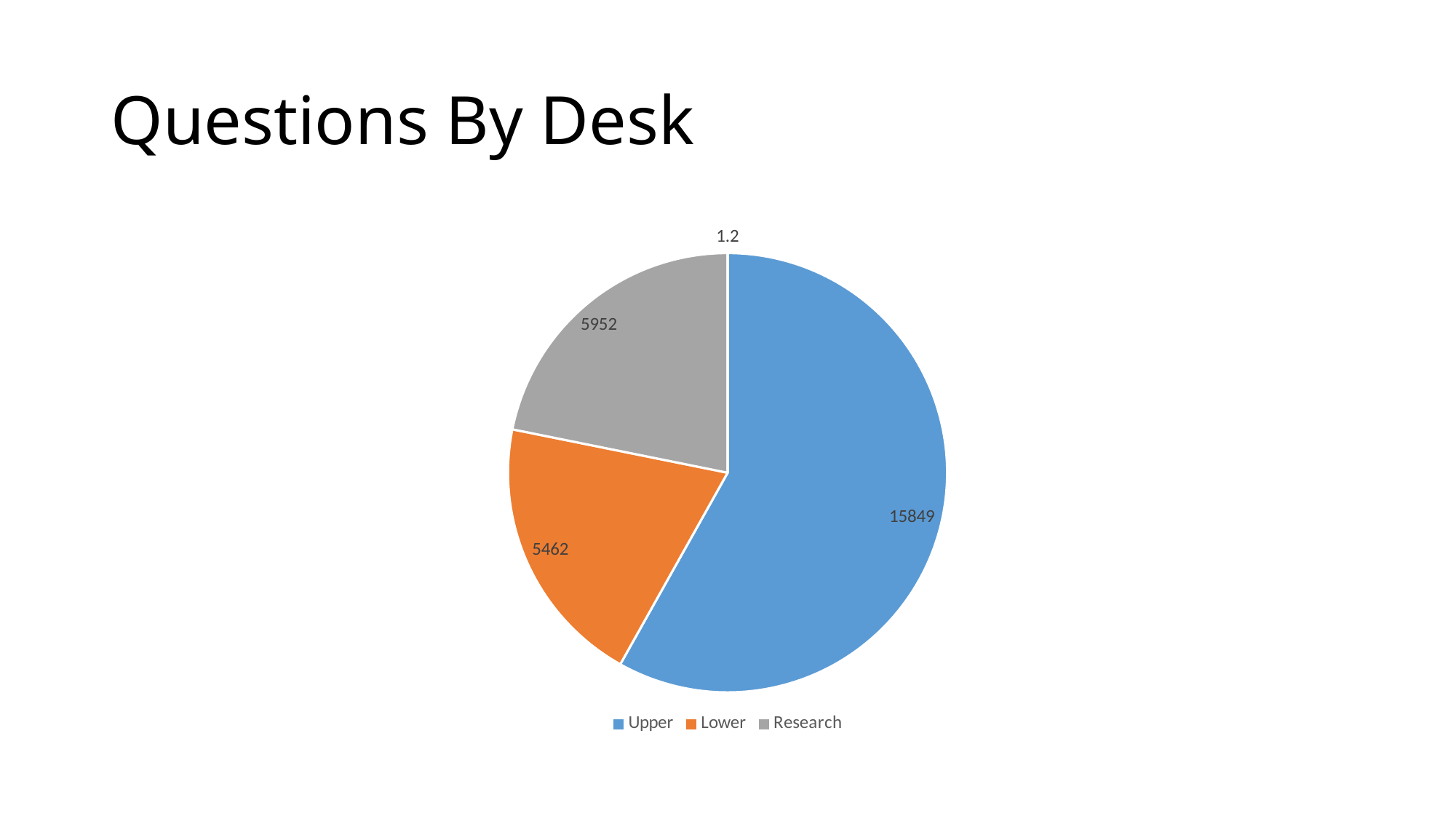
What is the value for Upper in the Questions By Desk pie chart? 15849 What is the difference between the Upper and Lower values? 10387 Which is larger, the value for Research or the value for Lower? Research How many entries does the legend list? 3 Which desk has the highest number of questions? Upper What is the difference between the Upper and Research values? 9897 Which of the legend desks has the lowest number of questions? Lower What is the value for Lower in the Questions By Desk pie chart? 5462 What is the difference between the Research and Lower values? 490 What is the value for Research in the Questions By Desk pie chart? 5952 What kind of chart is shown on the slide? Pie chart What is the title of the slide? Questions By Desk